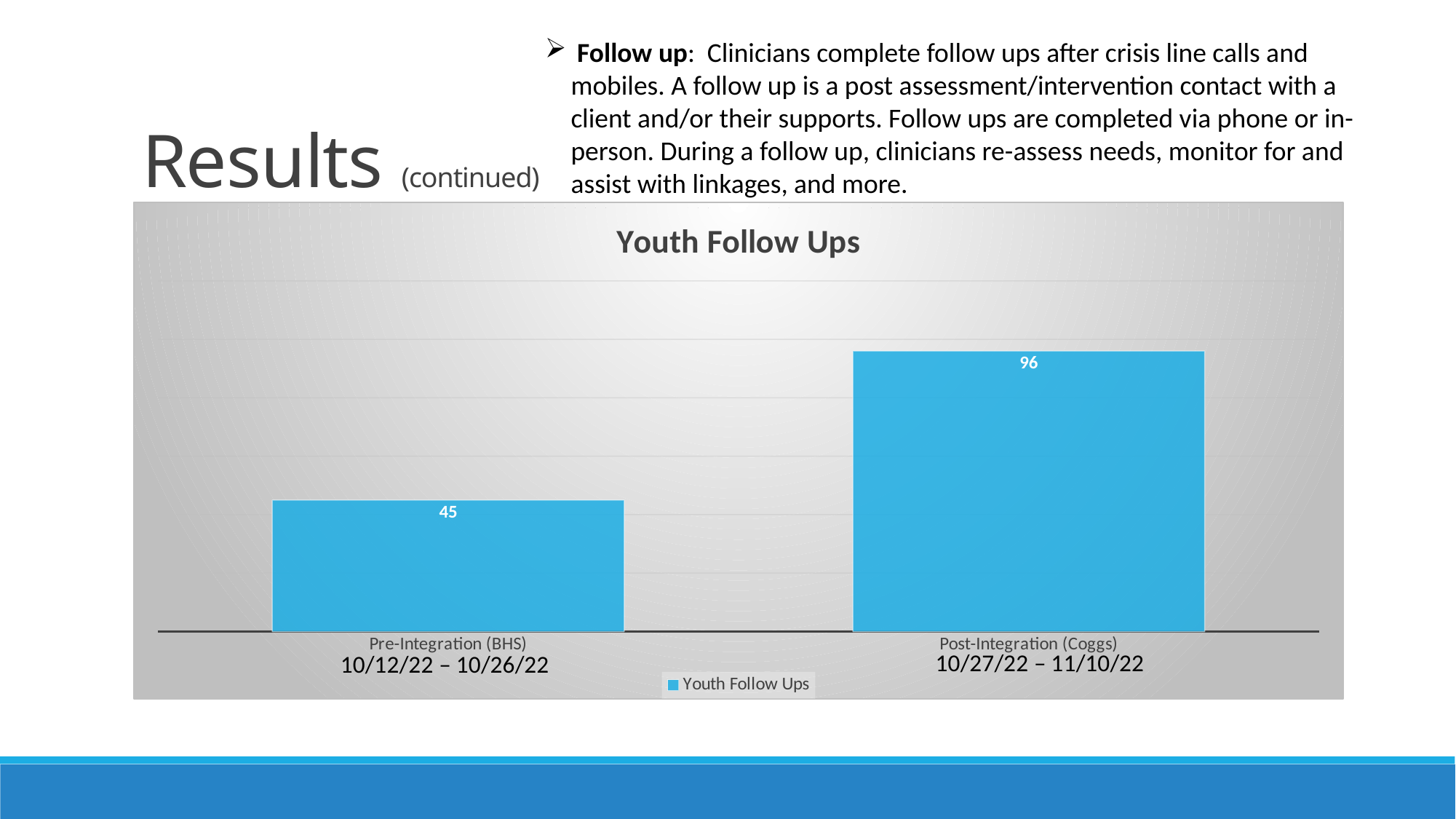
What is the value for Post-Integration (Coggs) in the Youth Follow Ups chart? 96 What date range is shown under the Post-Integration (Coggs) bar in the Youth Follow Ups chart? 10/27/22 – 11/10/22 Do the values rise or fall from Pre-Integration (BHS) to Post-Integration (Coggs) in the Youth Follow Ups chart? Rise What kind of chart is the Youth Follow Ups chart? Bar chart Which is larger in the Youth Follow Ups chart: Pre-Integration (BHS) or Post-Integration (Coggs)? Post-Integration (Coggs) What is the value for Pre-Integration (BHS) in the Youth Follow Ups chart? 45 What is the title of the chart on the slide? Youth Follow Ups How many series does the legend of the Youth Follow Ups chart list? 1 Which category has the highest value in the Youth Follow Ups chart? Post-Integration (Coggs) What is the difference between the Post-Integration (Coggs) and Pre-Integration (BHS) values in the Youth Follow Ups chart? 51 Which category has the lowest value in the Youth Follow Ups chart? Pre-Integration (BHS) How many categories are shown in the Youth Follow Ups chart? 2